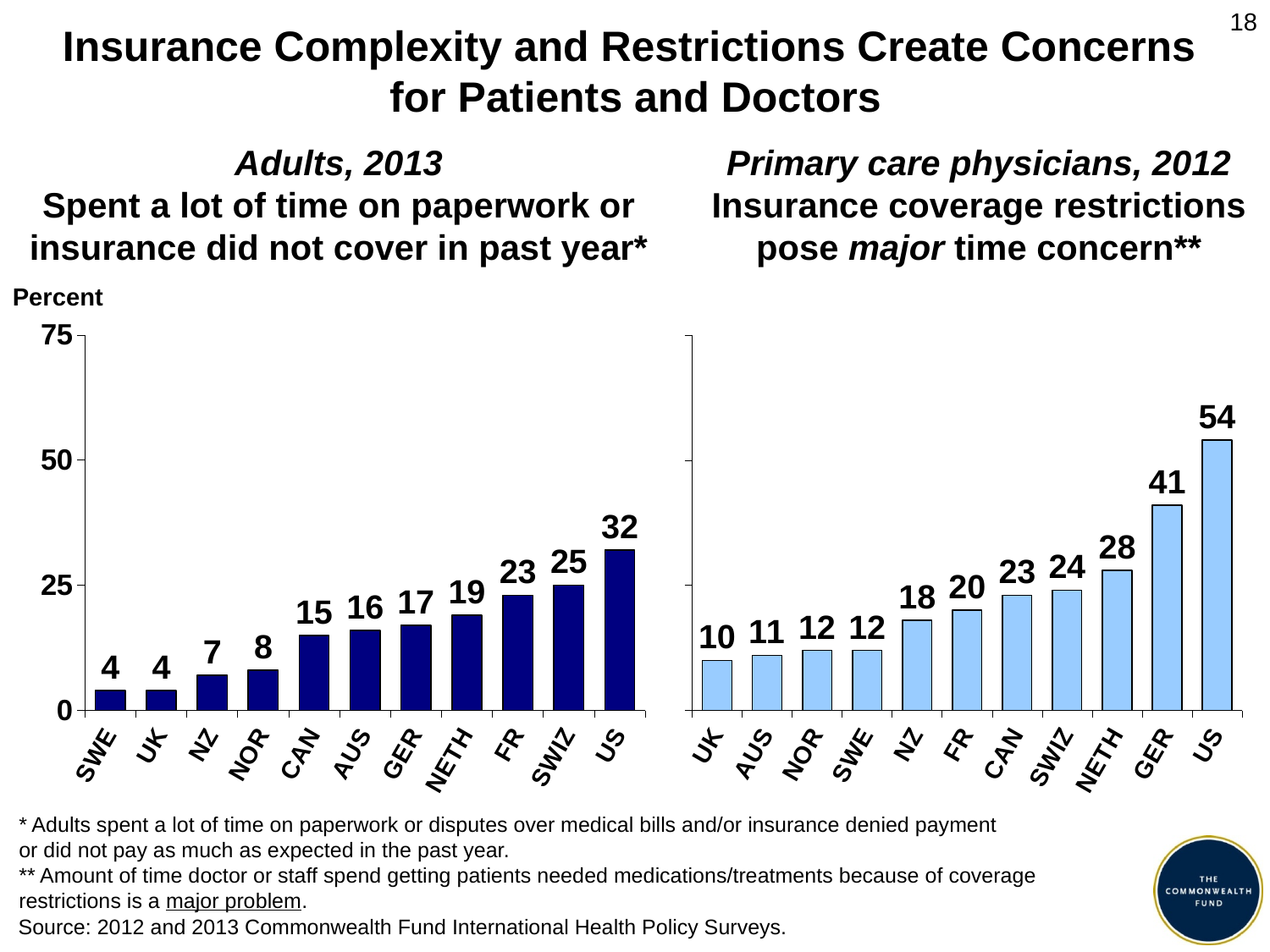
In the Primary care physicians, 2012 chart (right), what is the value for GER? 41 In the Primary care physicians, 2012 chart (right), what is the difference between the US and GER values? 13 In the Adults, 2013 chart (left), which is larger, the value for FR or the value for NETH? FR In the Primary care physicians, 2012 chart (right), do the values rise or fall from left to right? rise What is the label on the y axis of the left chart? Percent In the Adults, 2013 chart (left), what is the difference between the SWIZ and CAN values? 10 In the Primary care physicians, 2012 chart (right), which country has the lowest value? UK How many countries are shown in the Adults, 2013 chart (left)? 11 In the Adults, 2013 chart (left), which country has the highest value? US In the Adults, 2013 chart (left), what is the value for the US? 32 In the Primary care physicians, 2012 chart (right), is the value for the US greater or less than 50? greater What kind of chart is the Primary care physicians, 2012 chart (right)? bar chart